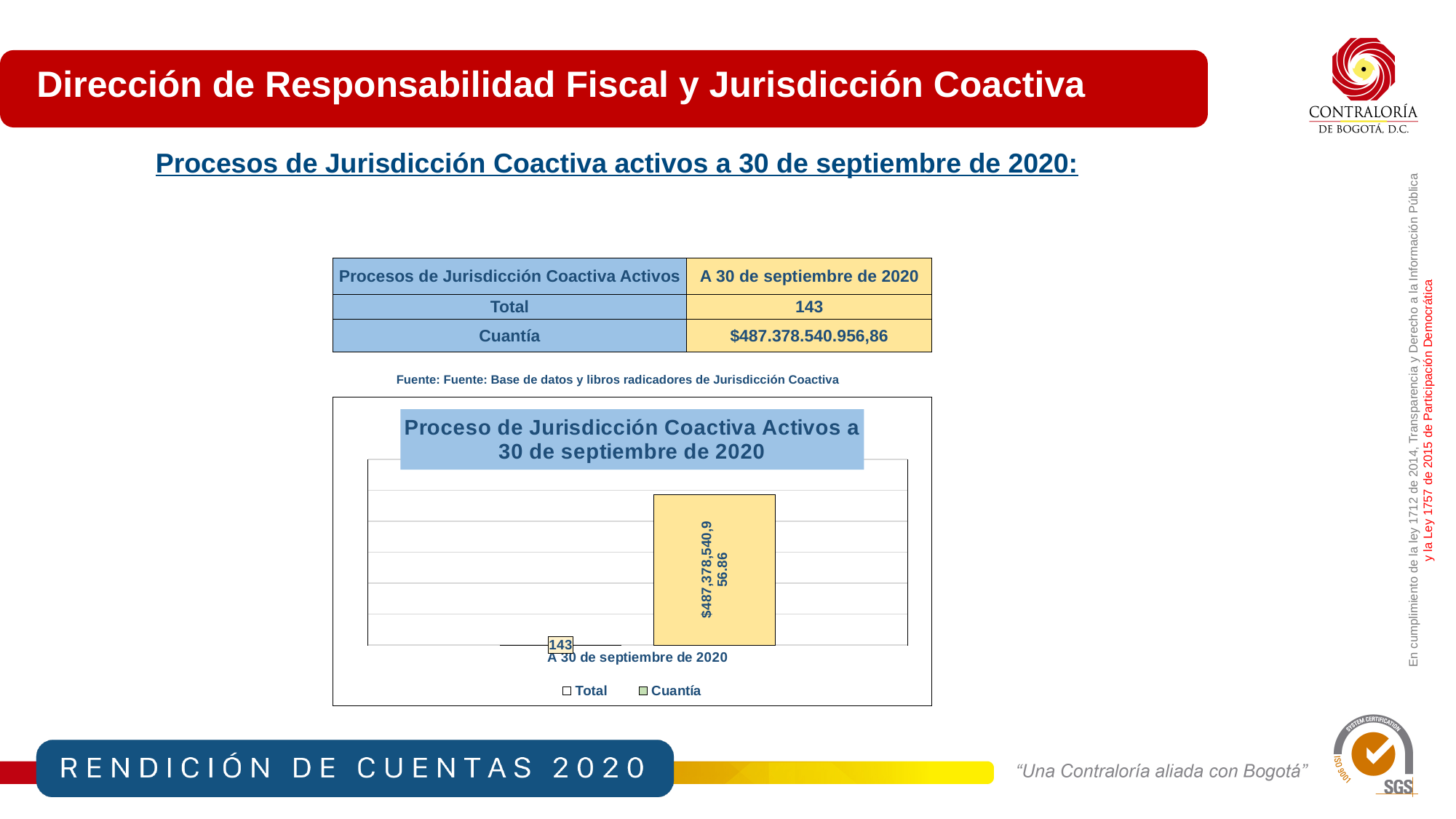
Which series has the largest value in the chart? Cuantía Which series has the higher value in the chart, Total or Cuantía? Cuantía What is the difference between the Cuantía value and the Total value in the chart? $487,378,540,813.86 What is the category label on the x axis of the chart? A 30 de septiembre de 2020 What kind of chart is shown on the slide? bar chart What is the value of the Total series in the chart? 143 What is the title of the chart? Proceso de Jurisdicción Coactiva Activos a 30 de septiembre de 2020 What is the value of the Cuantía series in the chart? $487,378,540,956.86 Which series has the smallest value in the chart? Total How many categories are shown on the x axis of the chart? 1 How many series does the chart's legend list? 2